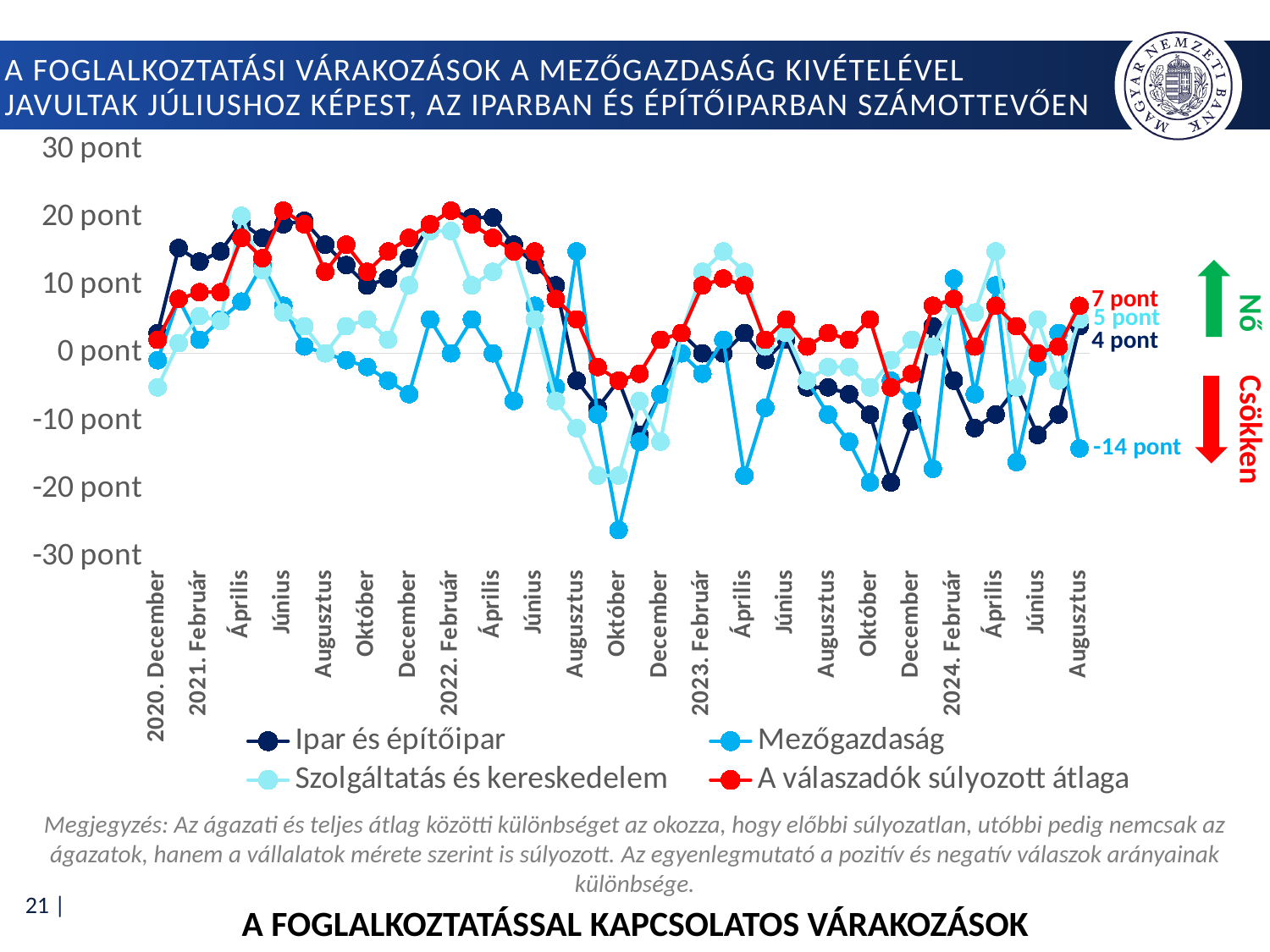
What is the value of Ipar és építőipar at 2024 Augusztus? 4 pont What is the value of A válaszadók súlyozott átlaga at 2024 Augusztus? 7 pont What is the title of the chart? A FOGLALKOZTATÁSSAL KAPCSOLATOS VÁRAKOZÁSOK How many series does the legend list? 4 At 2024 Augusztus, which is larger: Ipar és építőipar or Mezőgazdaság? Ipar és építőipar What kind of chart is shown on the slide? line chart What is the value of Mezőgazdaság at 2024 Augusztus? -14 pont What is the difference between A válaszadók súlyozott átlaga and Mezőgazdaság at 2024 Augusztus? 21 pont Which series has the highest value at 2024 Augusztus? A válaszadók súlyozott átlaga Is the value for Mezőgazdaság at 2022 Október greater or less than -20 pont? less What is the value of Szolgáltatás és kereskedelem at 2024 Augusztus? 5 pont Which series has the lowest value at 2024 Augusztus? Mezőgazdaság